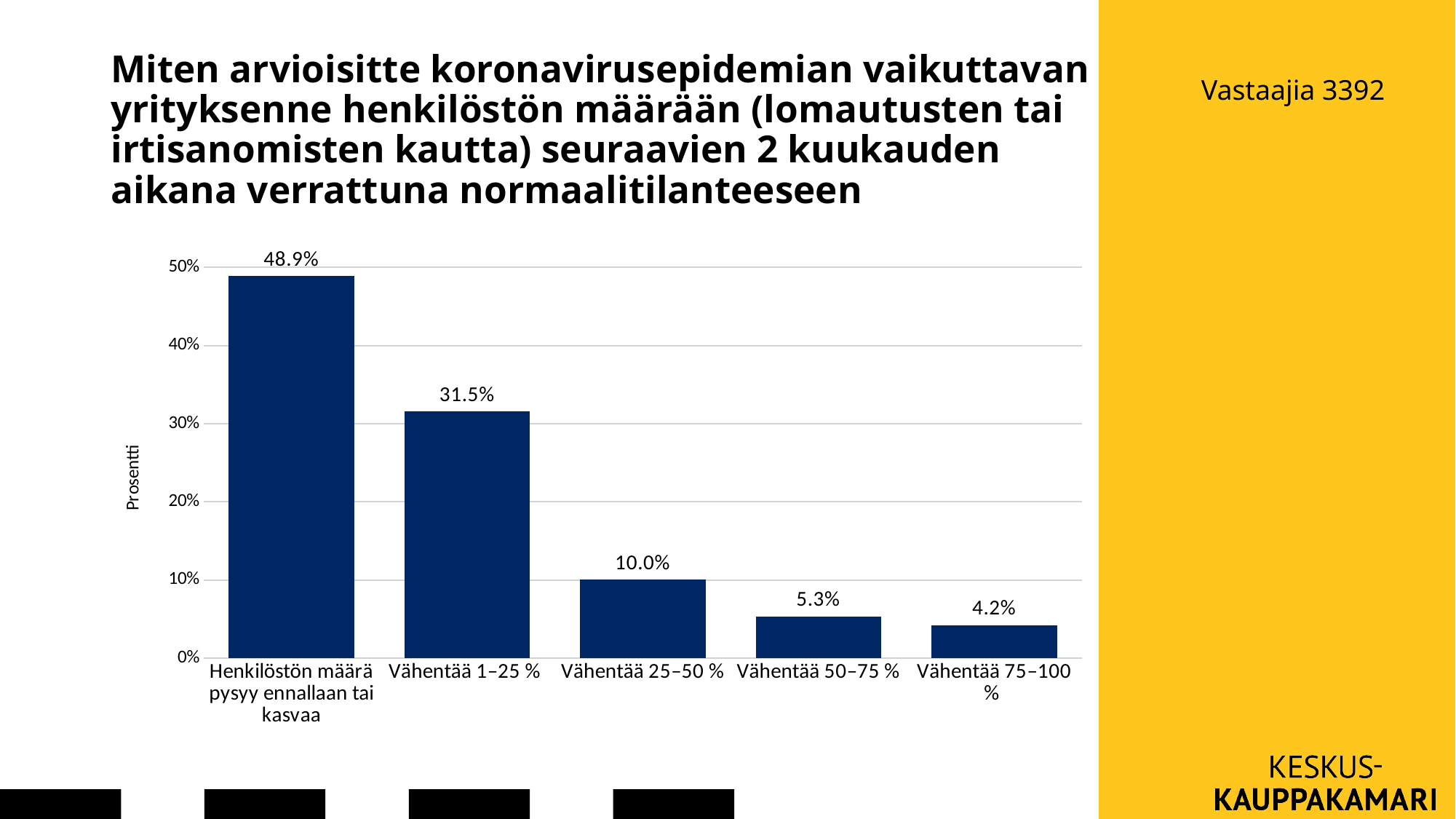
What is the difference between the values for "Henkilöstön määrä pysyy ennallaan tai kasvaa" and "Vähentää 1–25 %"? 17.4% What is the label of the vertical axis? Prosentti Which is larger, the value for "Vähentää 50–75 %" or "Vähentää 75–100 %"? Vähentää 50–75 % What is the value for "Vähentää 1–25 %"? 31.5% Which category has the highest value? Henkilöstön määrä pysyy ennallaan tai kasvaa Which category has the lowest value? Vähentää 75–100 % What is the value for "Vähentää 25–50 %"? 10.0% What kind of chart is shown on the slide? Bar chart What is the value for "Vähentää 75–100 %"? 4.2% Is the value for "Vähentää 1–25 %" greater or less than 30%? greater How many categories are shown on the x axis? 5 What is the value for "Henkilöstön määrä pysyy ennallaan tai kasvaa"? 48.9%